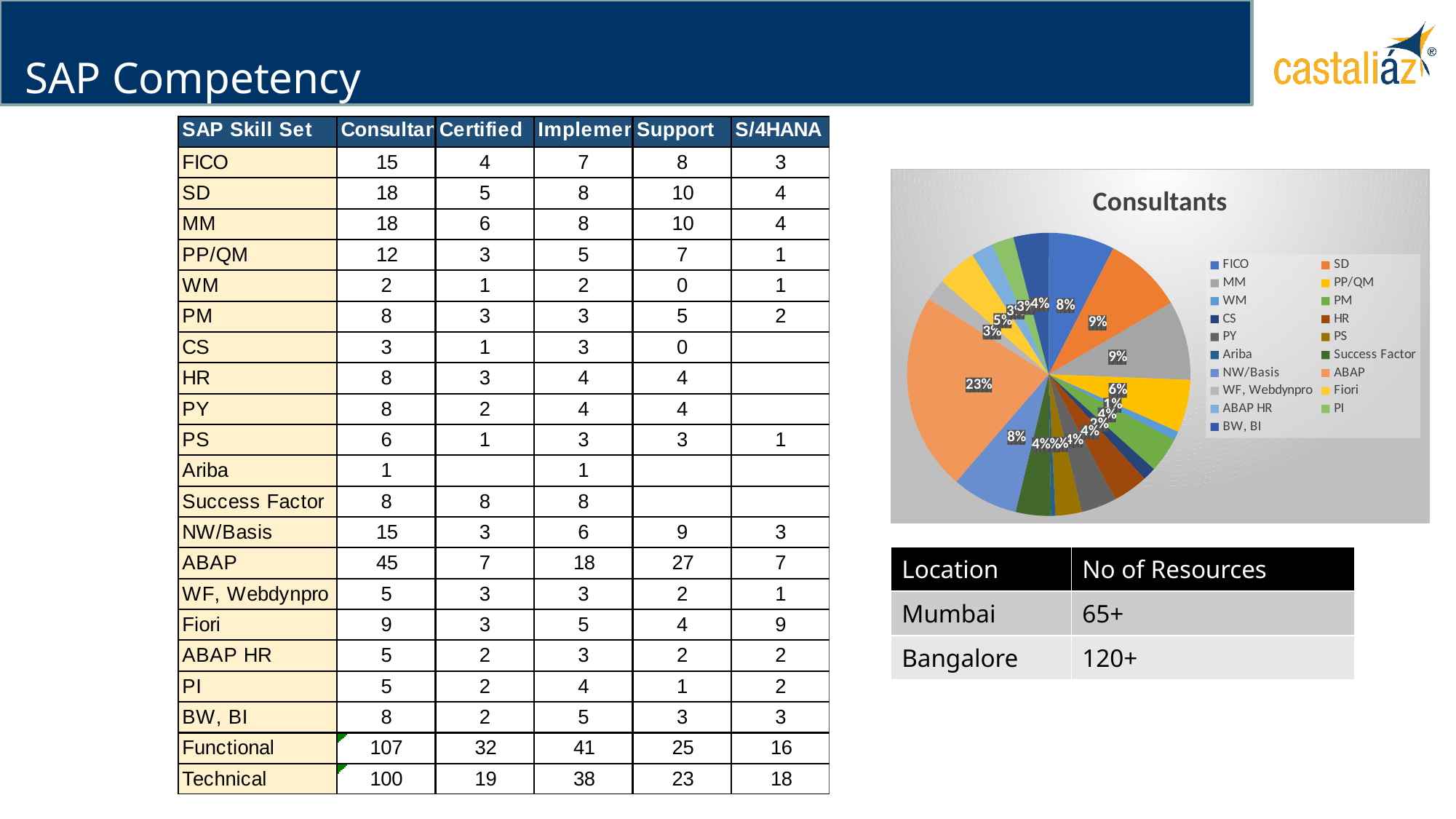
How many entries does the legend of the "Consultants" pie chart list? 19 In the "Consultants" pie chart, what share does SD have? 9% In the "Consultants" pie chart, what share does ABAP have? 23% In the "Consultants" pie chart, what share does FICO have? 8% What is the title of the pie chart on the slide? Consultants In the "Consultants" pie chart, which skill set has the largest slice? ABAP In the "Consultants" pie chart, which is larger, the ABAP slice or the FICO slice? ABAP In the "Consultants" pie chart, which is larger, the SD slice or the PP/QM slice? SD In the "Consultants" pie chart, what is the difference between the ABAP share and the FICO share? 15% What kind of chart is the "Consultants" chart? pie chart